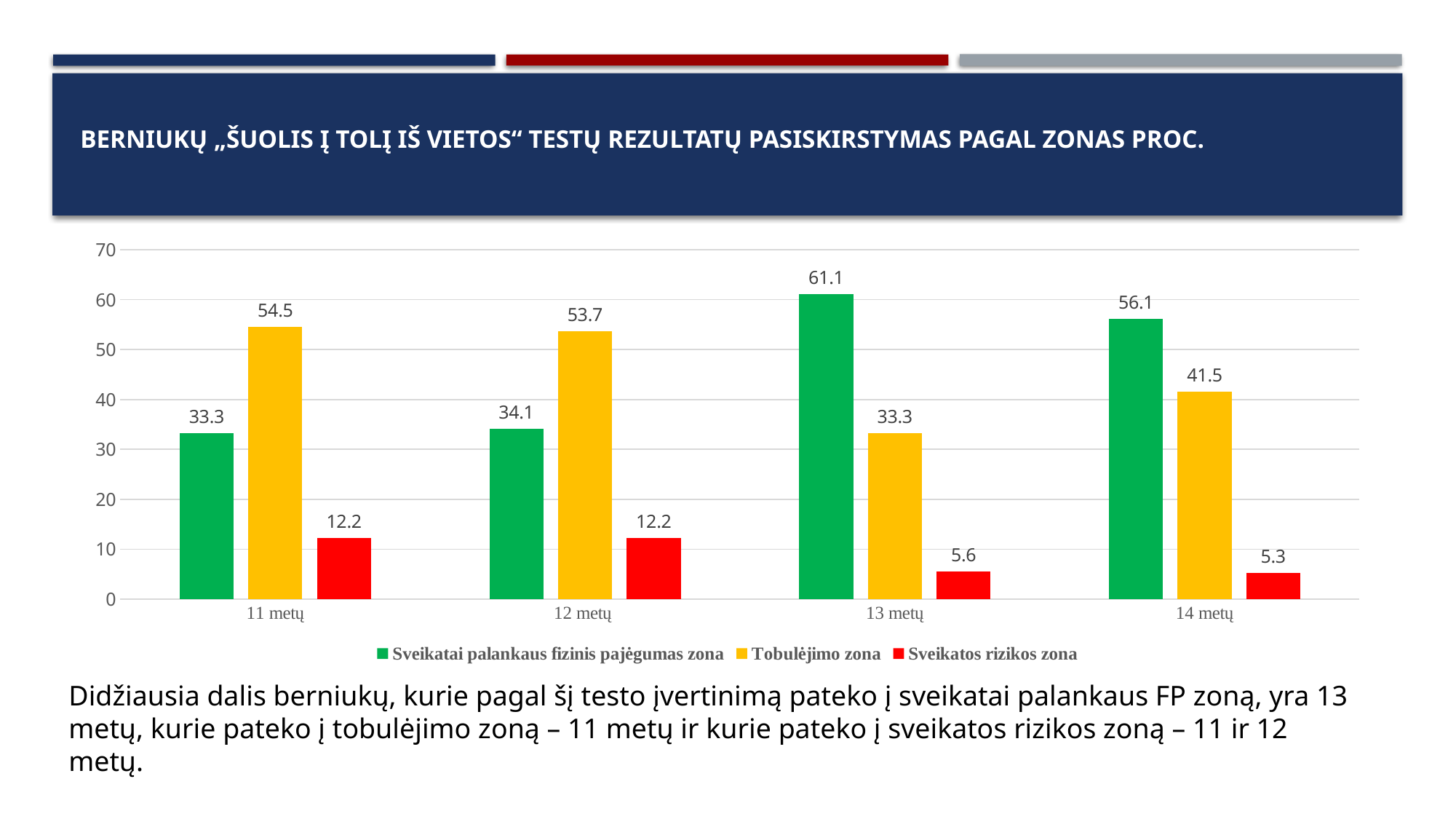
How many age groups are shown on the x axis? 4 Which age group has the highest value for "Sveikatai palankaus fizinis pajėgumas zona"? 13 metų Which colour represents "Sveikatos rizikos zona" in the chart? red What kind of chart is shown on the slide? bar chart How many series does the legend list? 3 What is the value for "Sveikatai palankaus fizinis pajėgumas zona" at 13 metų? 61.1 What is the difference between the "Tobulėjimo zona" value at 11 metų and at 14 metų? 13 What is the value for "Sveikatos rizikos zona" at 14 metų? 5.3 Which age group has the lowest value for "Tobulėjimo zona"? 13 metų Is the value for "Sveikatai palankaus fizinis pajėgumas zona" at 14 metų greater or less than 50? greater Which is larger at 12 metų: "Sveikatai palankaus fizinis pajėgumas zona" or "Tobulėjimo zona"? Tobulėjimo zona What is the value for "Tobulėjimo zona" at 11 metų? 54.5